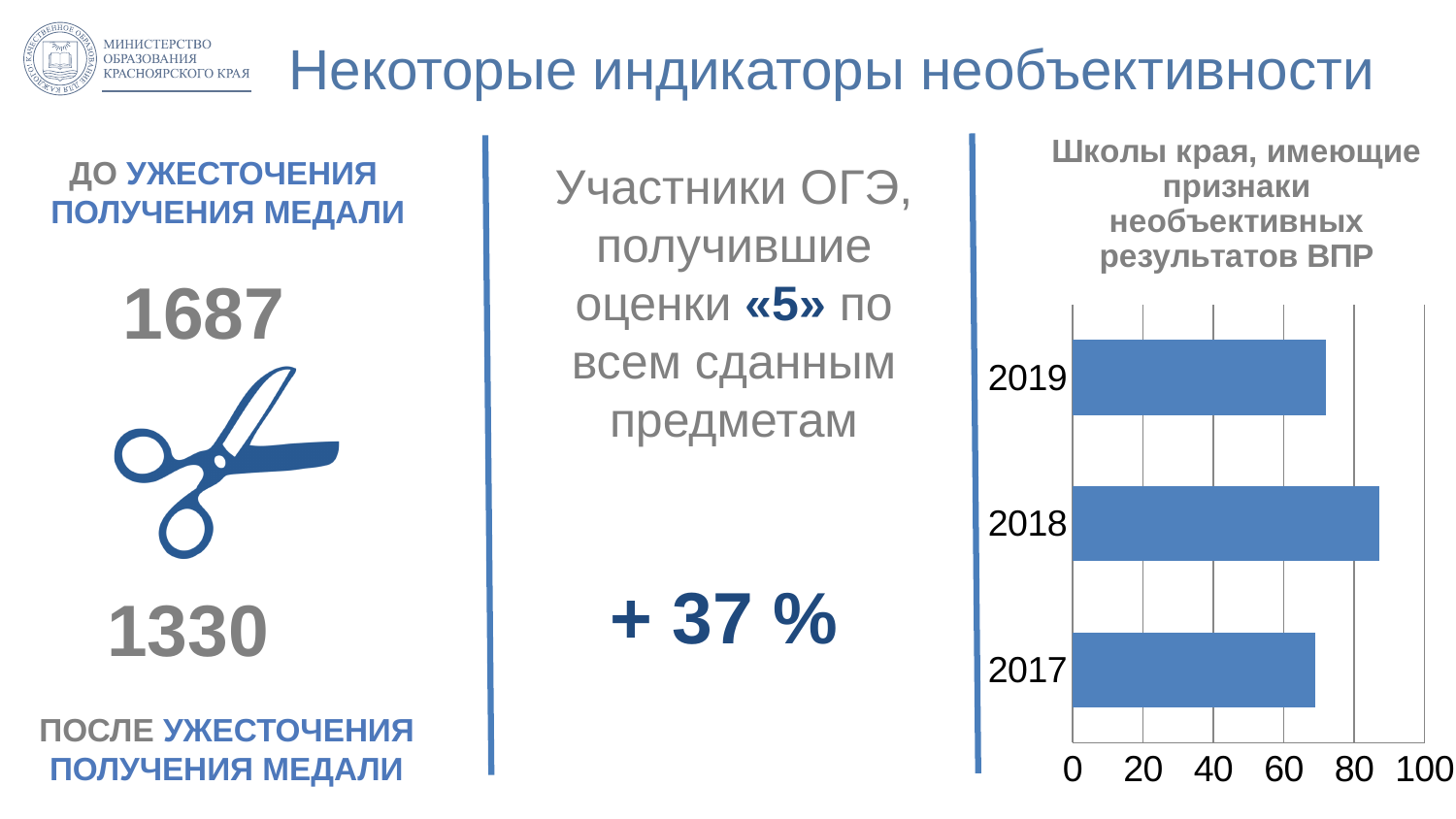
What is the title of the chart on the right side of the slide? Школы края, имеющие признаки необъективных результатов ВПР In the chart on the right, which is larger: the value for 2018 or the value for 2017? 2018 In the chart on the right, is the value for 2018 greater or less than 80? greater In the chart on the right, which is larger: the value for 2018 or the value for 2019? 2018 In the chart on the right, is the value for 2019 greater or less than 80? less What is the maximum value shown on the horizontal axis of the chart on the right? 100 In the chart on the right, which year has the highest value? 2018 How many years (categories) are plotted in the chart on the right? 3 In the chart on the right, is the value for 2017 greater or less than 80? less What kind of chart is shown on the right side of the slide? bar chart